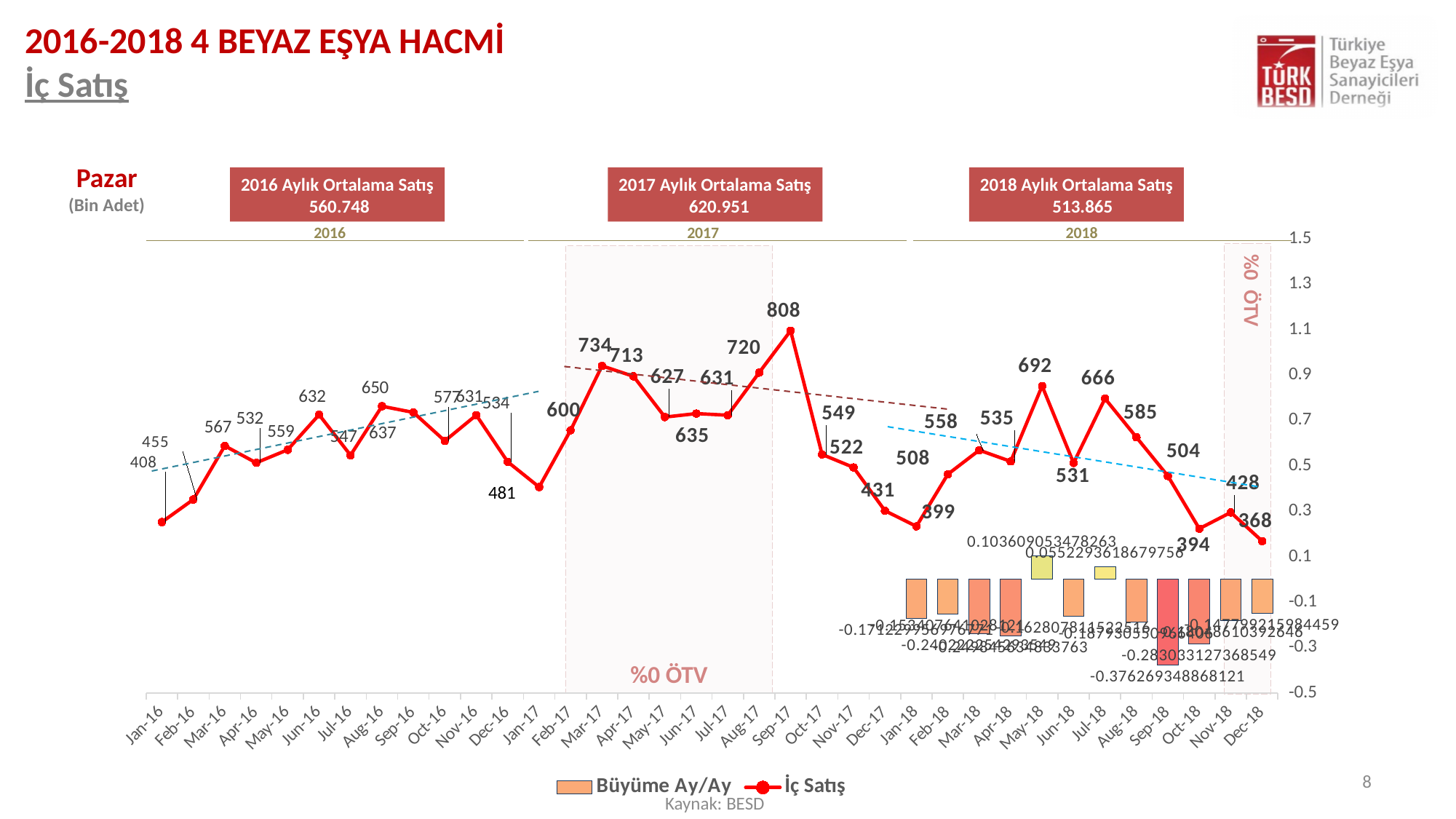
How many series does the legend list? 2 What is the İç Satış value for Sep-17? 808 Which month has the larger İç Satış value, May-18 or Jul-18? May-18 Does the İç Satış line rise or fall from Jul-18 to Dec-18? fall Which month has the highest İç Satış value? Sep-17 What is the 2017 Aylık Ortalama Satış shown on the slide? 620.951 What is the İç Satış value for Dec-18? 368 What is the İç Satış value for Jan-16? 408 What is the İç Satış value for Mar-17? 734 How many monthly data points does the İç Satış line have? 36 Which month has the lowest İç Satış value? Dec-18 What is the difference between the İç Satış values for Sep-17 and Oct-17? 259